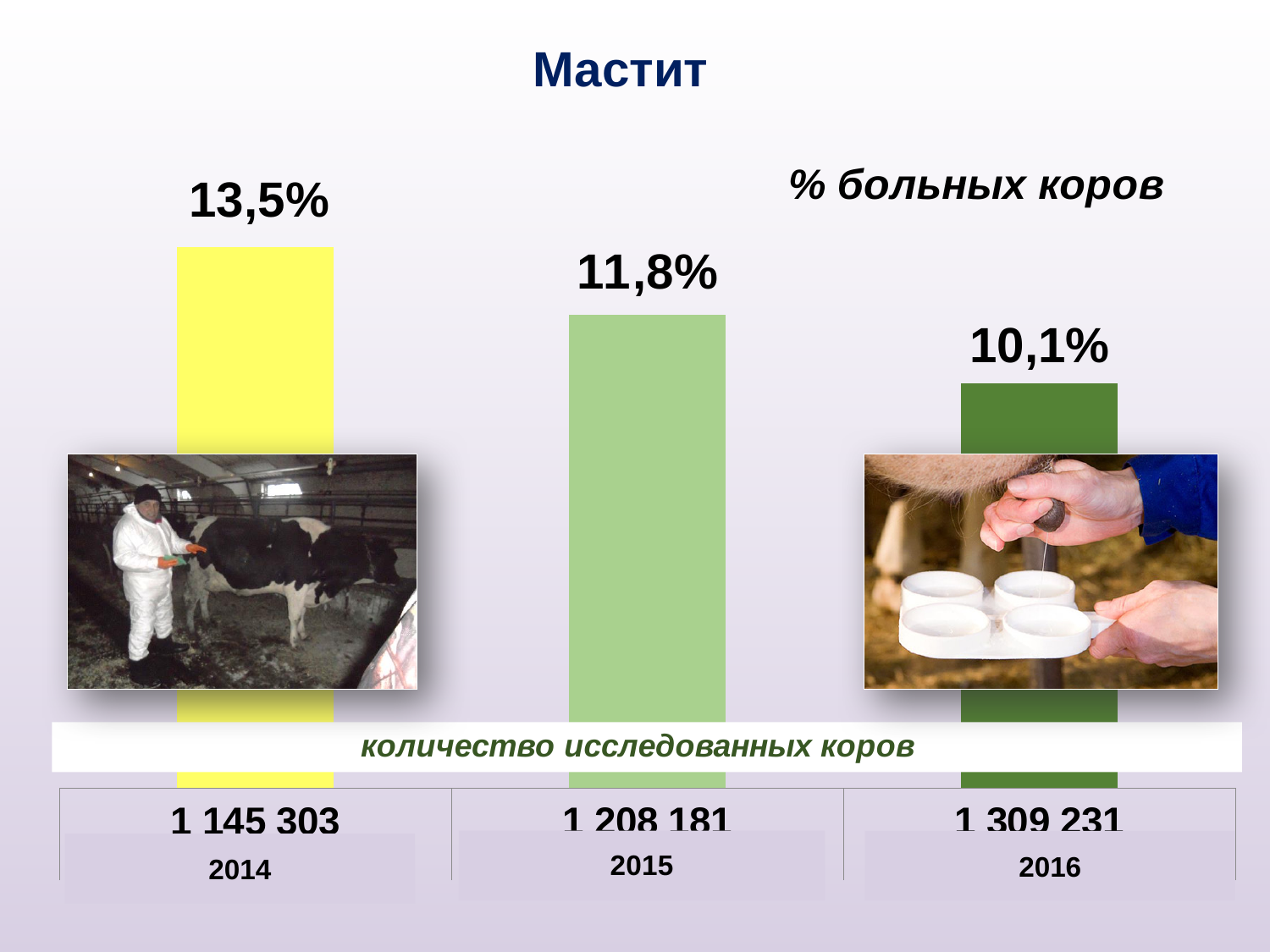
Which year has the highest percentage of sick cows? 2014 How many years (bars) are shown in the chart? 3 Which year has the lowest percentage of sick cows? 2016 What is the title of the chart? Мастит What percentage of sick cows is shown for 2016? 10,1% What is the difference in the percentage of sick cows between 2014 and 2016? 3,4 percentage points What percentage of sick cows (% больных коров) is shown for 2014? 13,5% Which year has more examined cows, 2014 or 2016? 2016 Does the percentage of sick cows rise or fall from 2014 to 2016? Fall What is the difference in the percentage of sick cows between 2015 and 2016? 1,7 percentage points How many examined cows (количество исследованных коров) are shown for 2015? 1 208 181 What kind of chart is shown on the slide? Bar chart